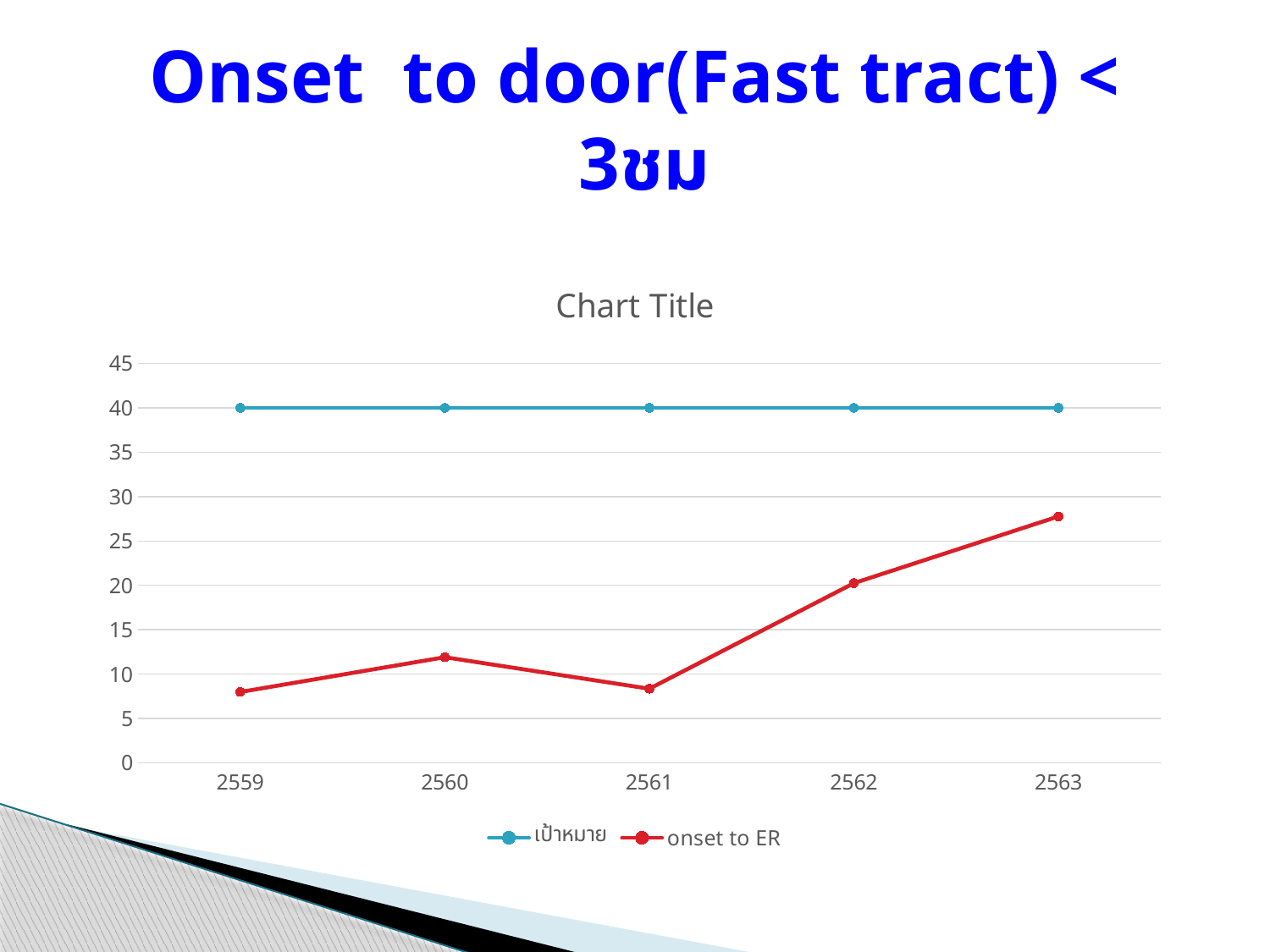
In which year is the onset to ER value highest? 2563 In which year is the onset to ER value lowest? 2559 How many years are shown on the x axis? 5 Is the onset to ER value for 2562 greater or less than 15? greater Is the onset to ER value for 2559 greater or less than 10? less What is the value of the เป้าหมาย series in 2563? 40 What is the value of the เป้าหมาย series in 2559? 40 Is the onset to ER value for 2563 greater or less than 30? less Which is larger, the onset to ER value in 2560 or in 2562? 2562 What kind of chart is shown on the slide? line chart How many series does the legend list? 2 What is the title printed above the chart? Chart Title